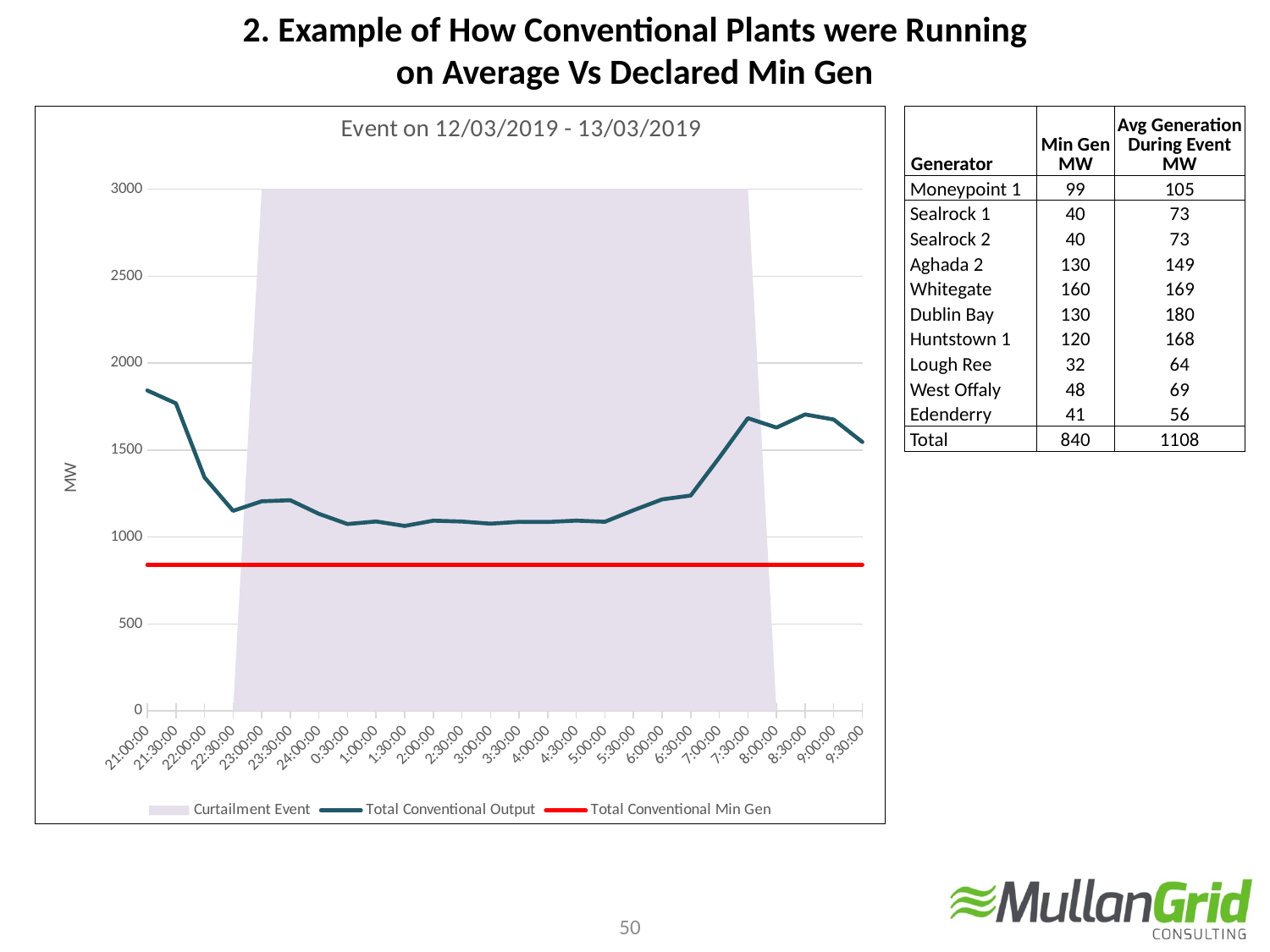
What kind of chart is shown on the slide? line chart Which is larger, the Total Conventional Output at 21:00:00 or at 3:00:00? 21:00:00 Is the Total Conventional Output at 3:00:00 greater or less than 1500? less Is the Total Conventional Min Gen line greater or less than 1000? less How many time points are labelled along the x axis of the chart? 26 What is the title of the chart? Event on 12/03/2019 - 13/03/2019 How many entries does the chart legend list? 3 Is the Total Conventional Output at 21:00:00 greater or less than 1500? greater What label is shown on the vertical axis of the chart? MW Does the Total Conventional Output rise or fall between 21:00:00 and 23:00:00? fall At which time point is the Total Conventional Output highest? 21:00:00